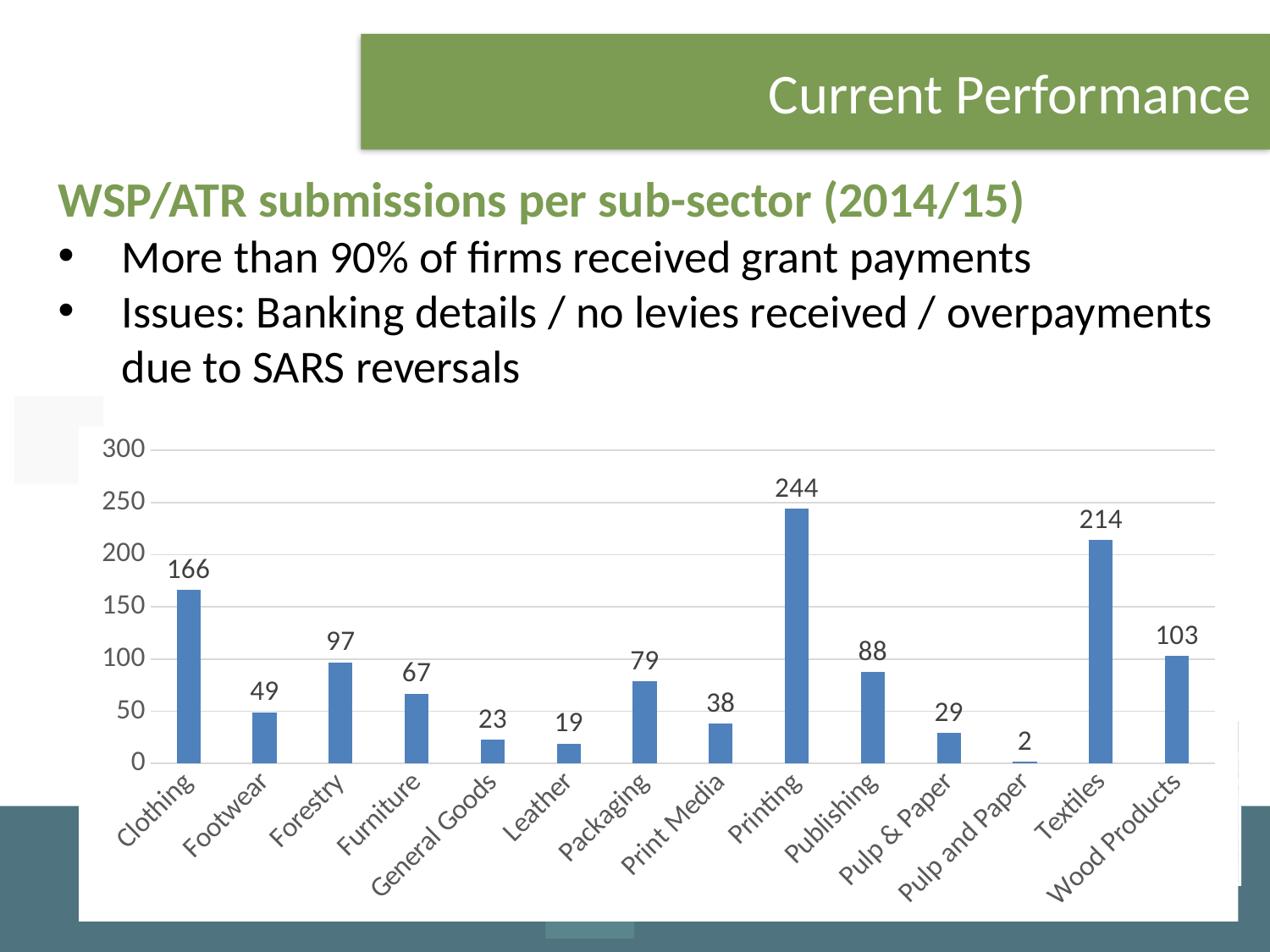
What kind of chart is shown on the slide? bar chart What is the difference between the values for Clothing and Footwear? 117 How many sub-sectors are shown on the x axis? 14 Is the value for Packaging greater or less than 100? less What is the value for Printing? 244 Which is larger, the value for Forestry or the value for Wood Products? Wood Products What is the difference between the values for Printing and Textiles? 30 What is the value for Pulp & Paper? 29 What is the value for Clothing? 166 Which sub-sector has the highest value? Printing What is the highest value shown on the y axis? 300 Which sub-sector has the lowest value? Pulp and Paper